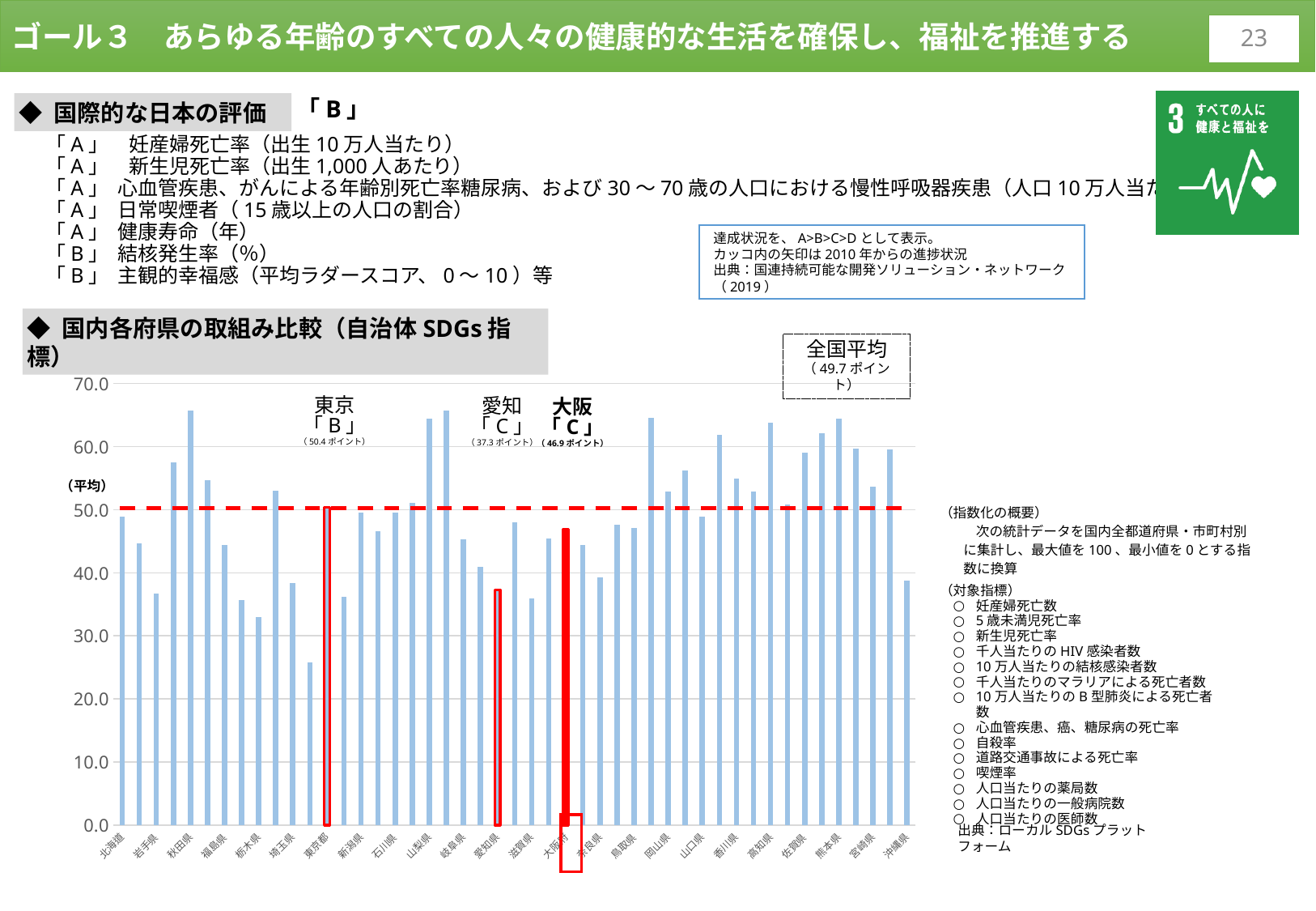
What is the value shown for 東京 on the bar chart? 50.4 ポイント What is the difference between the values for 東京 and 大阪? 3.5 ポイント What is the difference between the values for 大阪 and 愛知? 9.6 ポイント What kind of chart is used to compare the prefectures? bar chart Is the value for 秋田県 greater or less than 50.0? greater What is the 全国平均 value indicated by the dashed line on the chart? 49.7 ポイント Which is larger, the value for 大阪 or the 全国平均? 全国平均 What is the value shown for 大阪 on the bar chart? 46.9 ポイント What is the value shown for 愛知 on the bar chart? 37.3 ポイント Which has the larger value, 東京 or 大阪? 東京 What rating is shown above the 東京 bar on the chart? 「B」 Is the value for 岩手県 greater or less than 50.0? less